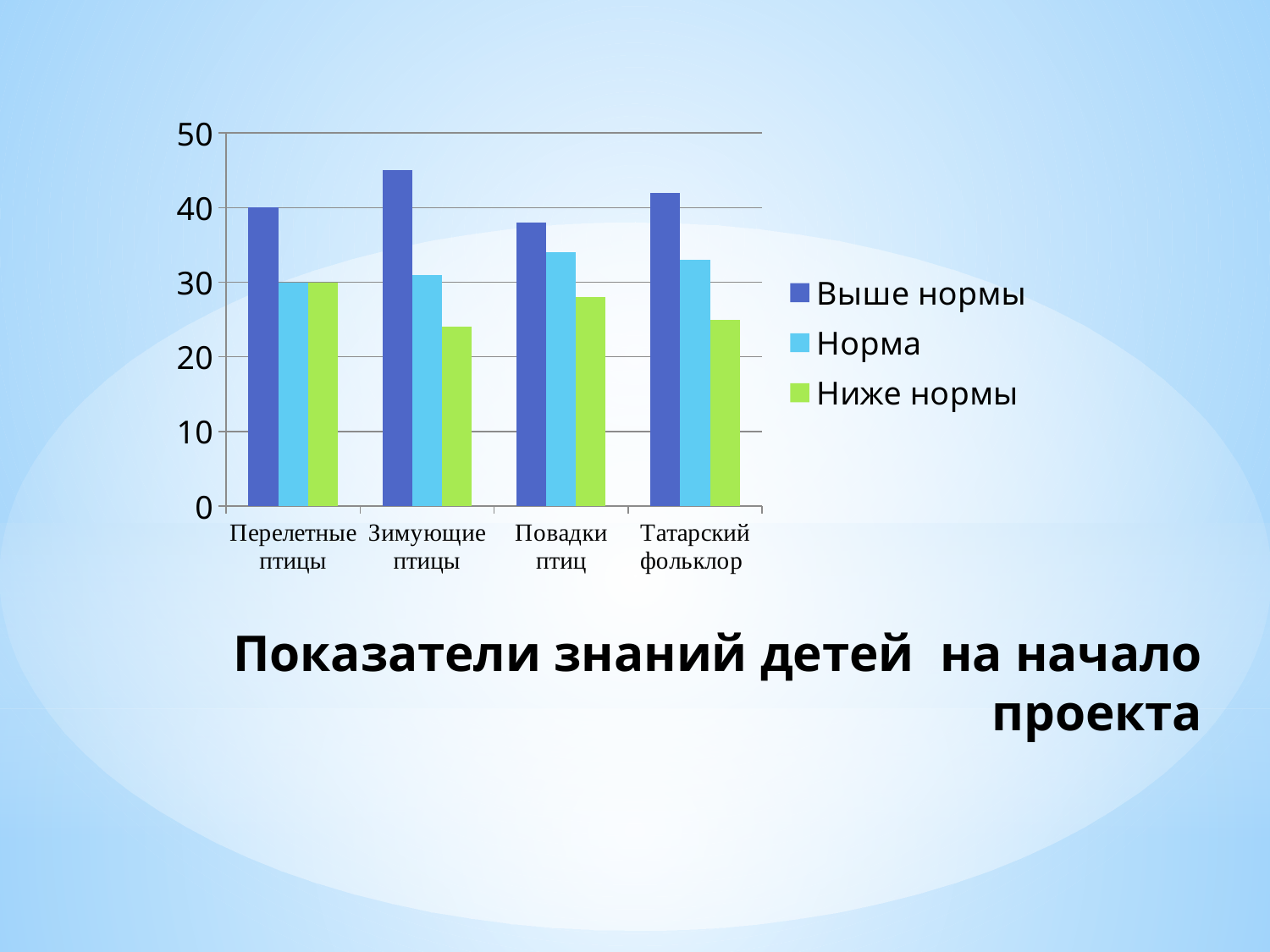
How many series does the legend list? 3 What is the title text shown below the chart? Показатели знаний детей на начало проекта Which series is shown in green in the legend? Ниже нормы Is the value of "Выше нормы" for "Зимующие птицы" greater or less than 40? greater What is the value of "Норма" for "Перелетные птицы"? 30 Which is larger for "Повадки птиц": "Норма" or "Ниже нормы"? Норма What is the value of "Выше нормы" for "Перелетные птицы"? 40 Is the value of "Ниже нормы" for "Татарский фольклор" greater or less than 30? less Which category has the highest "Выше нормы" value? Зимующие птицы What kind of chart is shown on the slide? bar chart How many categories are shown on the x axis? 4